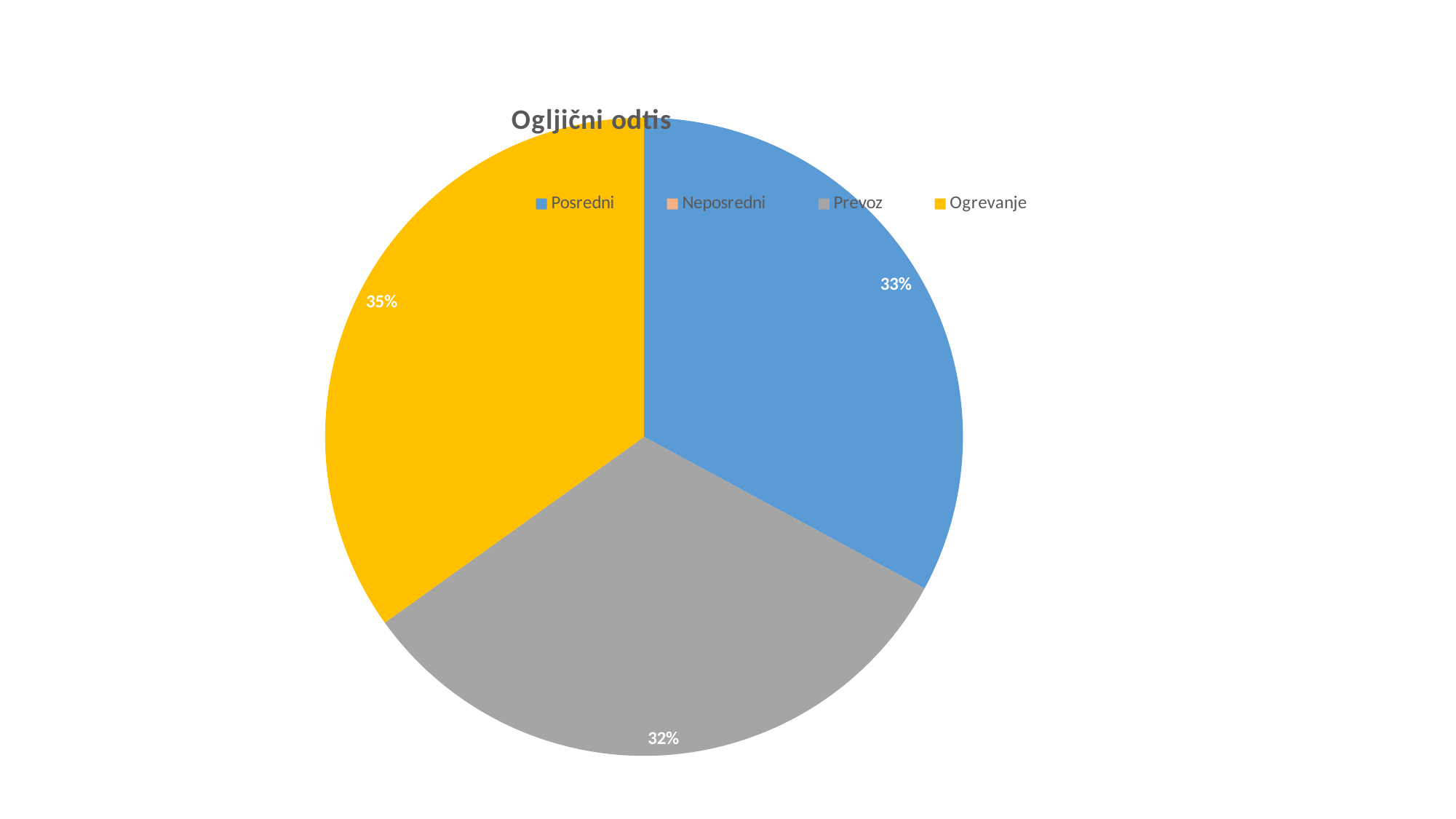
How many entries does the legend list? 4 Which is larger, the share for Ogrevanje or the share for Posredni? Ogrevanje What share of the pie does Prevoz have? 32% What is the title of the chart? Ogljični odtis What kind of chart is shown on the slide? Pie chart Which category has the largest slice of the pie? Ogrevanje What share of the pie does Ogrevanje have? 35% What share of the pie does Posredni have? 33% What colour is the Ogrevanje slice? Yellow What is the difference in percentage points between the Ogrevanje share and the Posredni share? 2 What is the difference in percentage points between the Ogrevanje share and the Prevoz share? 3 Which is larger, the share for Posredni or the share for Prevoz? Posredni